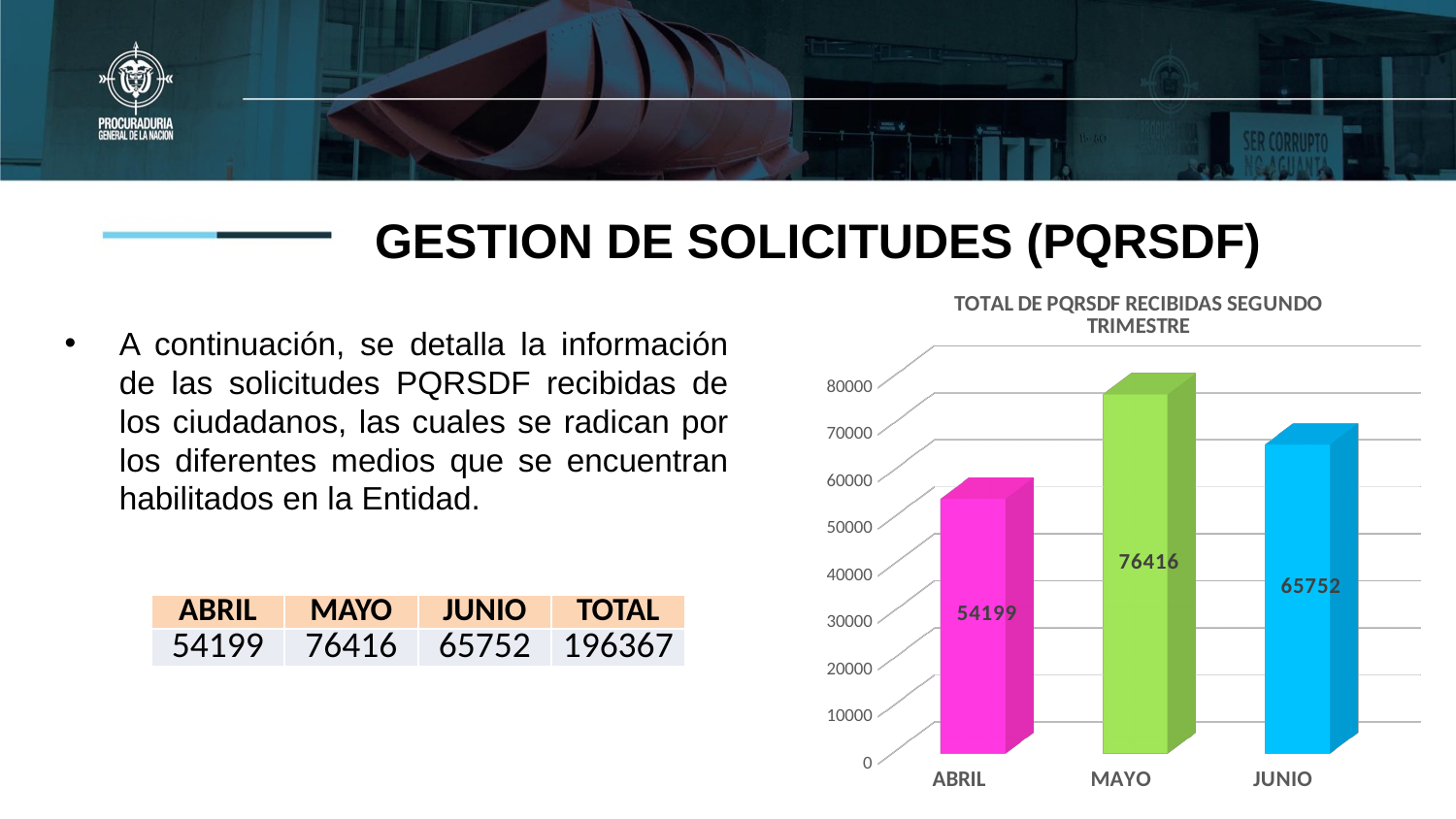
Which is larger, the value for JUNIO or the value for ABRIL? JUNIO How many months are shown on the x axis of the chart? 3 What kind of chart is shown on the slide? bar chart What is the difference between the values for MAYO and ABRIL? 22217 What is the value for ABRIL in the chart? 54199 What is the title of the chart? TOTAL DE PQRSDF RECIBIDAS SEGUNDO TRIMESTRE What is the value for JUNIO in the chart? 65752 What is the value for MAYO in the chart? 76416 What is the difference between the values for MAYO and JUNIO? 10664 Which month has the lowest value in the chart? ABRIL Is the value for ABRIL greater or less than 60000? less Which month has the highest value in the chart? MAYO